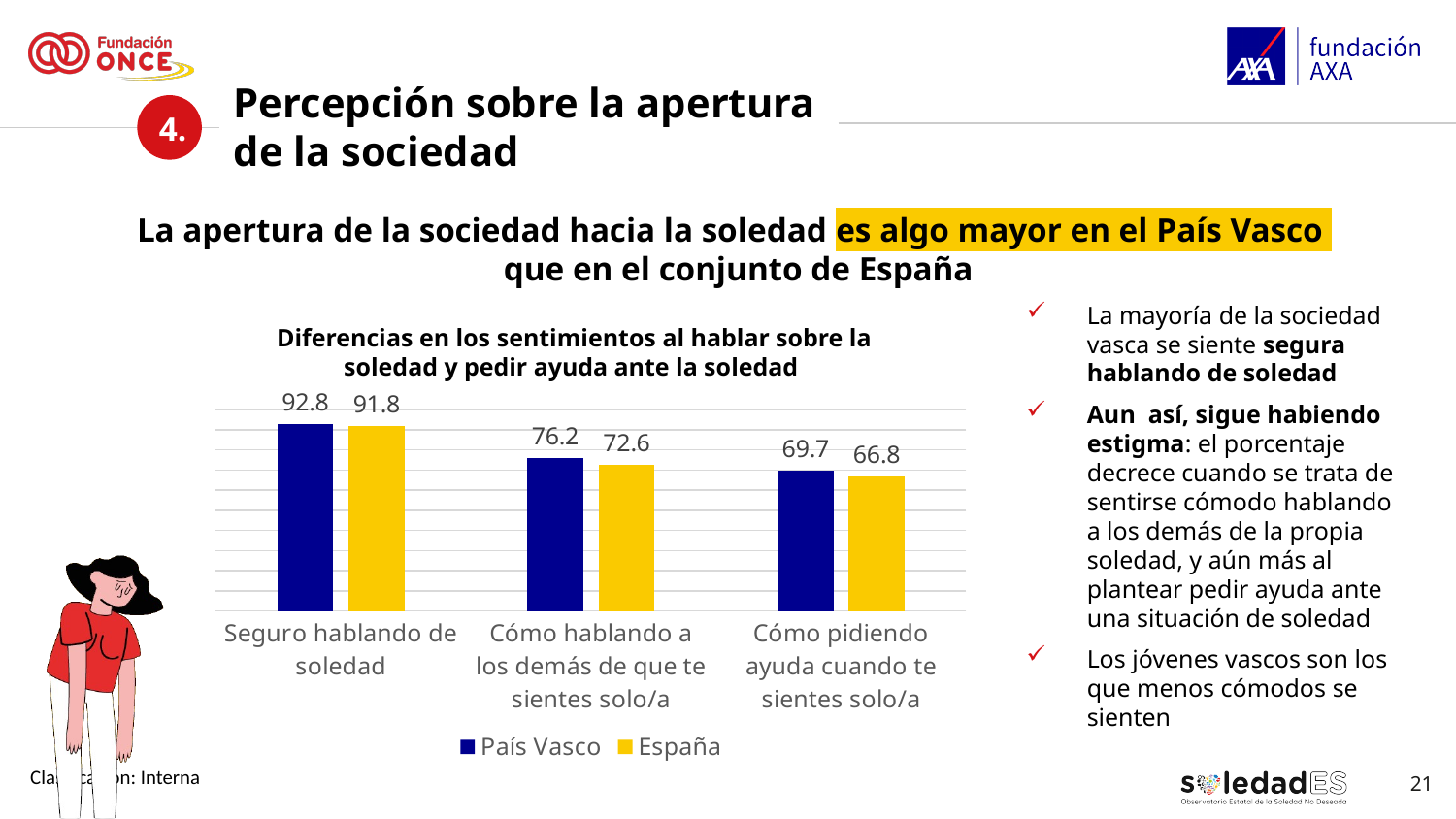
In the category "Cómo pidiendo ayuda cuando te sientes solo/a", which series has the larger value, País Vasco or España? País Vasco What is the value for España in the category "Cómo pidiendo ayuda cuando te sientes solo/a"? 66.8 What is the difference between the País Vasco and España values in the category "Cómo hablando a los demás de que te sientes solo/a"? 3.6 What type of chart is shown on the slide? Bar chart What is the value for País Vasco in the category "Cómo hablando a los demás de que te sientes solo/a"? 76.2 Which category has the highest value for País Vasco? Seguro hablando de soledad What is the value for País Vasco in the category "Seguro hablando de soledad"? 92.8 Do the values for País Vasco rise or fall from left to right across the categories? Fall Which category has the lowest value for España? Cómo pidiendo ayuda cuando te sientes solo/a How many series does the chart legend list? 2 How many categories are shown on the x axis of the chart? 3 What is the value for España in the category "Seguro hablando de soledad"? 91.8